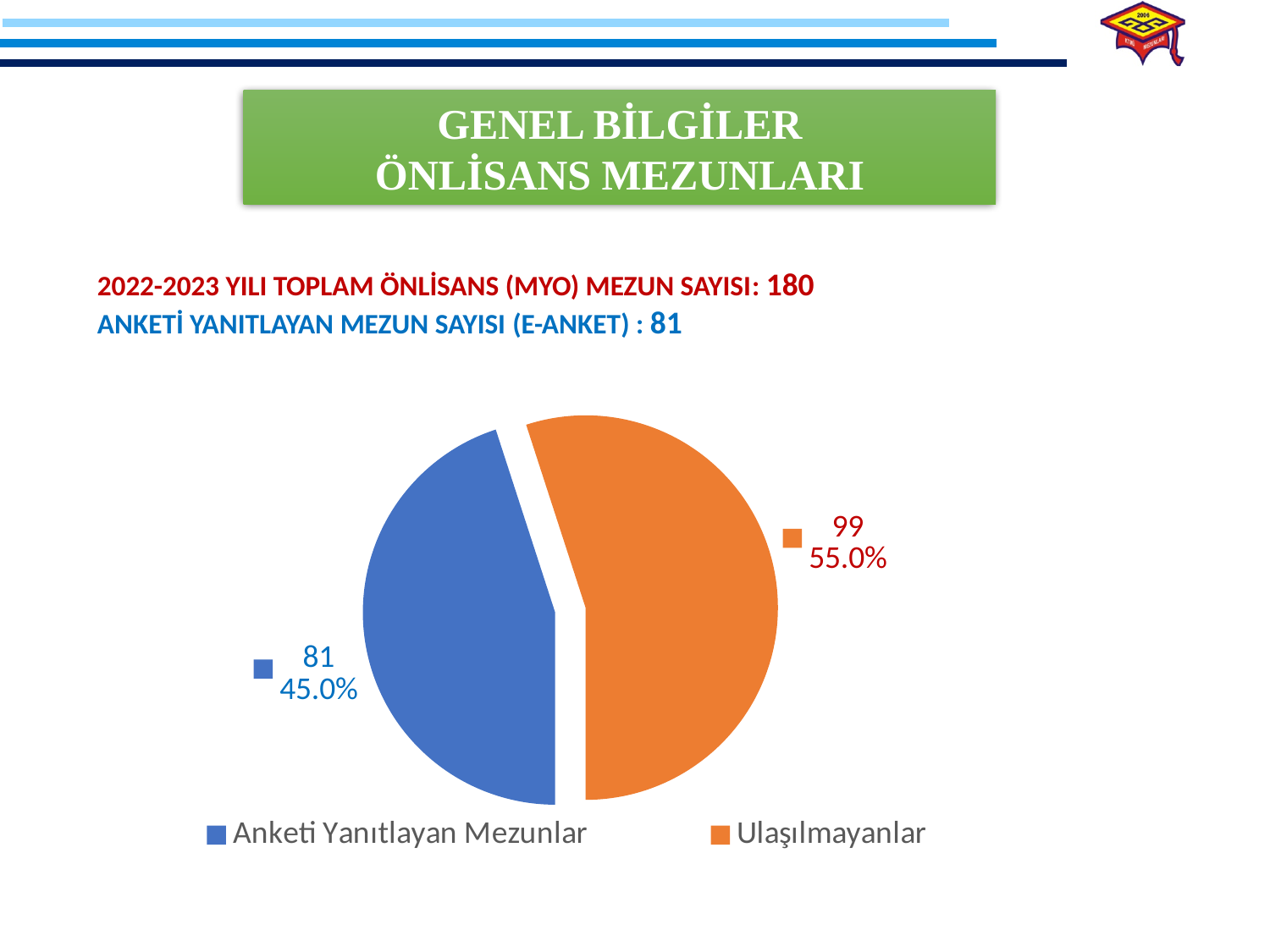
What share of the pie does Ulaşılmayanlar represent? 55.0% What colour is the Ulaşılmayanlar slice? orange What is the difference between the values for Ulaşılmayanlar and Anketi Yanıtlayan Mezunlar? 18 How many entries does the legend list? 2 What is the value for Ulaşılmayanlar? 99 How many slices does the pie chart have? 2 What kind of chart is shown on the slide? pie chart Which slice is the smallest? Anketi Yanıtlayan Mezunlar Which slice is the largest? Ulaşılmayanlar What is the value for Anketi Yanıtlayan Mezunlar? 81 What share of the pie does Anketi Yanıtlayan Mezunlar represent? 45.0% Which is larger, Anketi Yanıtlayan Mezunlar or Ulaşılmayanlar? Ulaşılmayanlar